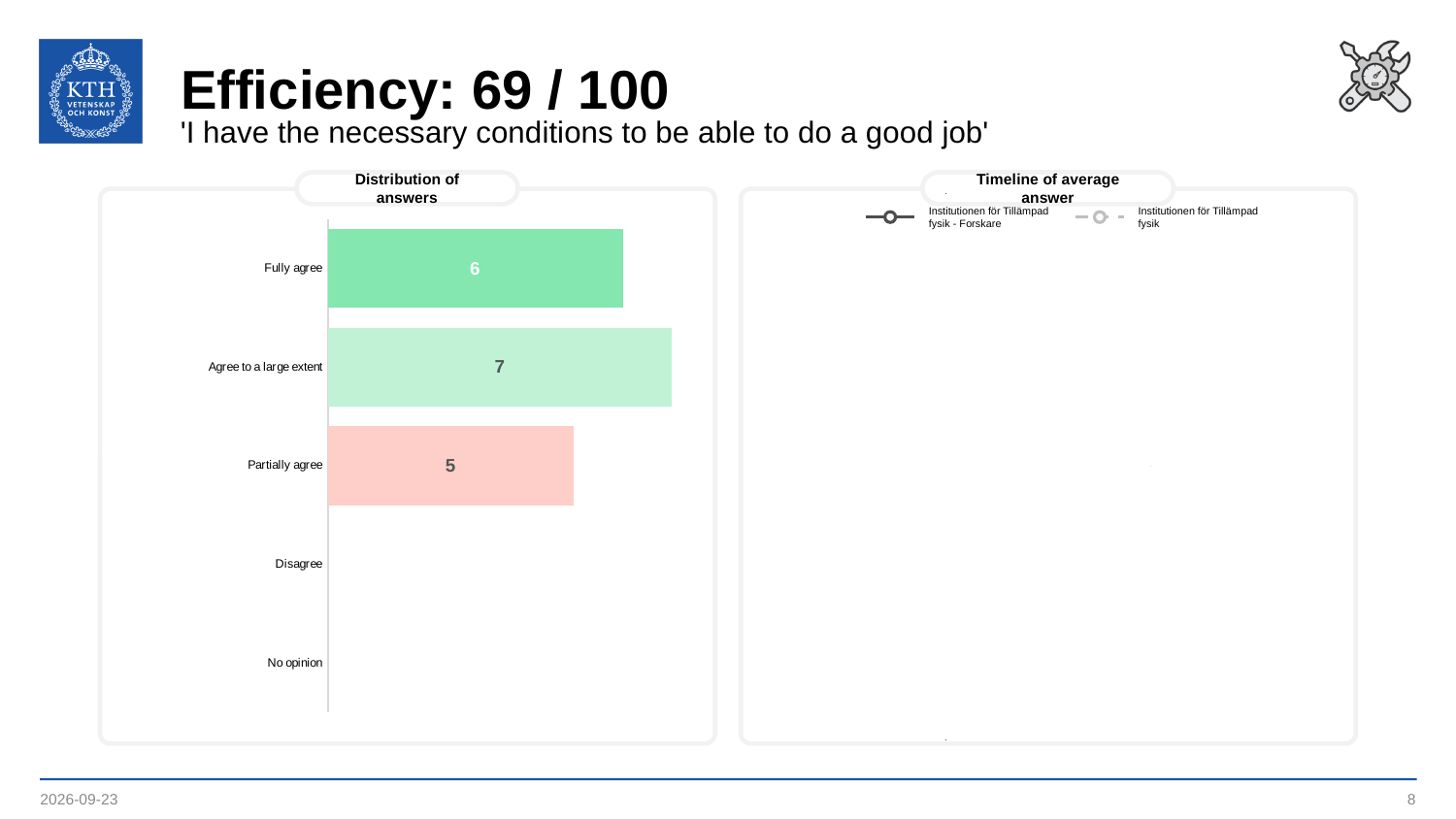
In the 'Distribution of answers' chart, what is the value for 'Partially agree'? 5 In the 'Distribution of answers' chart, what is the total of the values for 'Fully agree', 'Agree to a large extent' and 'Partially agree'? 18 In the 'Distribution of answers' chart, which category has the highest value? Agree to a large extent In the 'Distribution of answers' chart, what is the difference between the values for 'Agree to a large extent' and 'Partially agree'? 2 What kind of chart is the 'Distribution of answers' chart? Bar chart In the 'Distribution of answers' chart, which categories have no bar shown? Disagree and No opinion In the 'Distribution of answers' chart, which is larger: the value for 'Fully agree' or the value for 'Partially agree'? Fully agree In the 'Distribution of answers' chart, what is the value for 'Fully agree'? 6 How many series does the legend of the 'Timeline of average answer' chart list? 2 In the 'Distribution of answers' chart, which of the three categories with bars has the lowest value? Partially agree In the 'Distribution of answers' chart, what is the value for 'Agree to a large extent'? 7 In the 'Distribution of answers' chart, how many categories are listed on the axis? 5